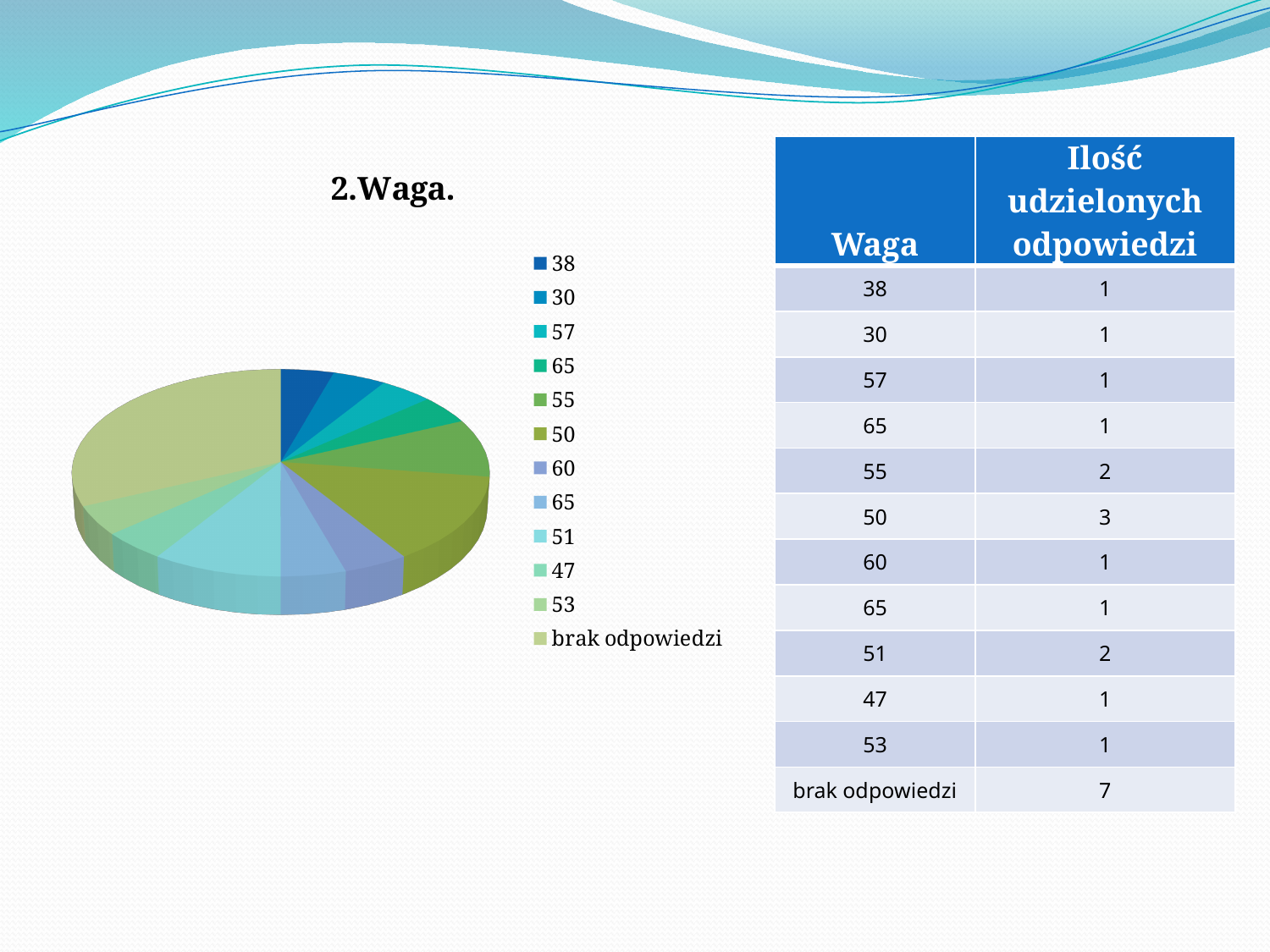
Which has the larger slice, 'brak odpowiedzi' or 51? brak odpowiedzi What is the last entry in the pie chart's legend? brak odpowiedzi What is the difference between the number of responses for 'brak odpowiedzi' and for 50? 4 Which category has the largest slice of the pie? brak odpowiedzi What is the title of the chart? 2.Waga. What kind of chart is shown on the slide? pie chart How many responses does the slide give for the weight 50? 3 How many categories does the pie chart's legend list? 12 How many responses does the slide give for the weight 51? 2 Which has the larger slice, 50 or 55? 50 What colour is the slice for 38 in the pie chart? dark blue How many responses does the slide give for 'brak odpowiedzi'? 7